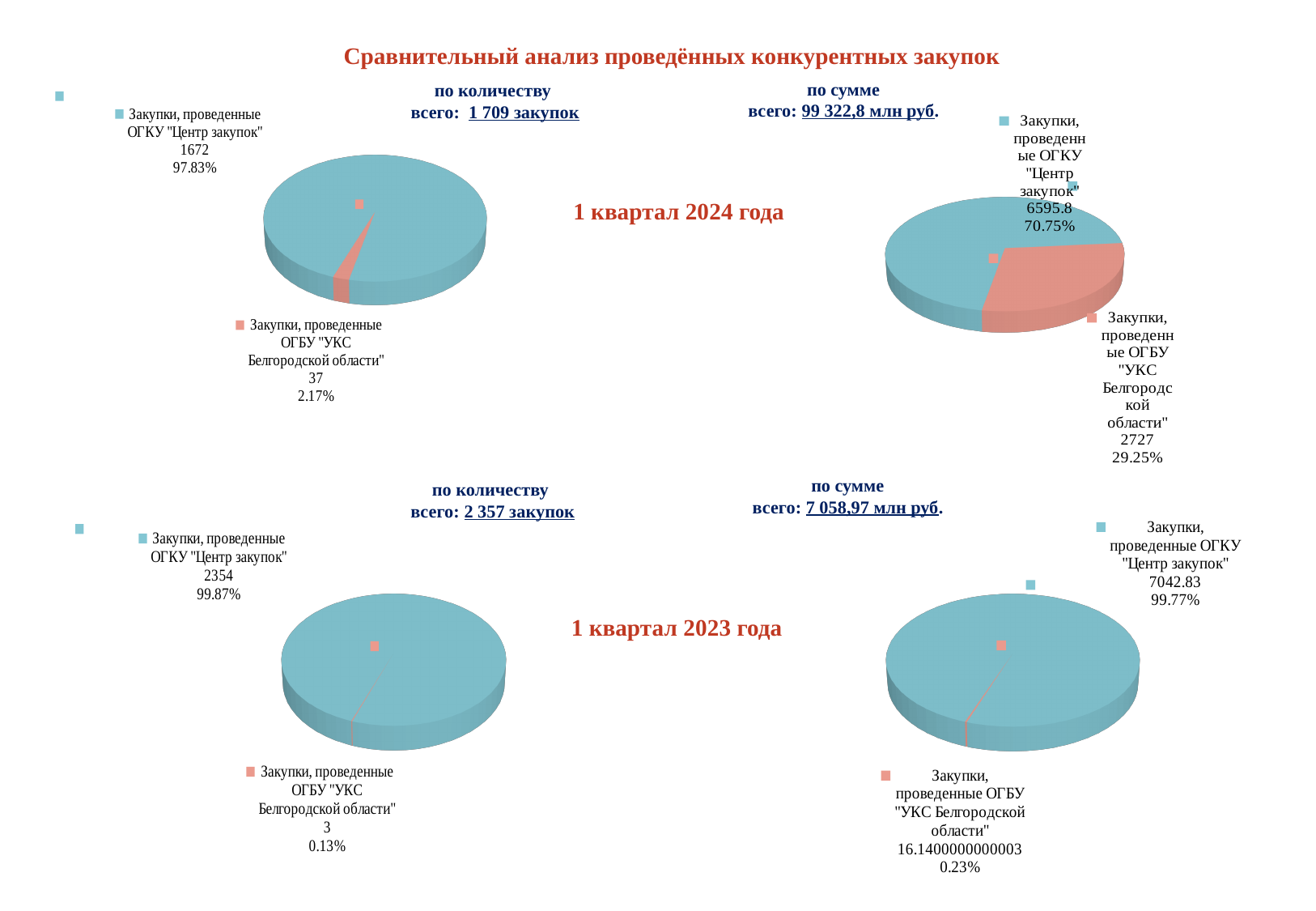
In the top-left pie chart (1 квартал 2024 года, по количеству), what share does Закупки, проведенные ОГБУ "УКС Белгородской области" have? 2.17% What kind of chart is used for the four charts on the slide? Pie chart In the top-right pie chart (1 квартал 2024 года, по сумме), what share does Закупки, проведенные ОГКУ "Центр закупок" have? 70.75% In the bottom-right pie chart (1 квартал 2023 года, по сумме), what share does Закупки, проведенные ОГБУ "УКС Белгородской области" have? 0.23% What is the title of the slide? Сравнительный анализ проведённых конкурентных закупок In the bottom-left pie chart (1 квартал 2023 года, по количеству), what value is shown for Закупки, проведенные ОГКУ "Центр закупок"? 2354 How many slices does the top-left pie chart (1 квартал 2024 года, по количеству) have? 2 In the top-right pie chart (1 квартал 2024 года, по сумме), what value is shown for Закупки, проведенные ОГБУ "УКС Белгородской области"? 2727 In the top-right pie chart (1 квартал 2024 года, по сумме), which slice is larger: ОГКУ "Центр закупок" or ОГБУ "УКС Белгородской области"? ОГКУ "Центр закупок" In the top-left pie chart (1 квартал 2024 года, по количеству), what value is shown for Закупки, проведенные ОГКУ "Центр закупок"? 1672 In the bottom-right pie chart (1 квартал 2023 года, по сумме), what value is shown for Закупки, проведенные ОГКУ "Центр закупок"? 7042.83 In the bottom-left pie chart (1 квартал 2023 года, по количеству), what is the difference between the values for ОГКУ "Центр закупок" and ОГБУ "УКС Белгородской области"? 2351